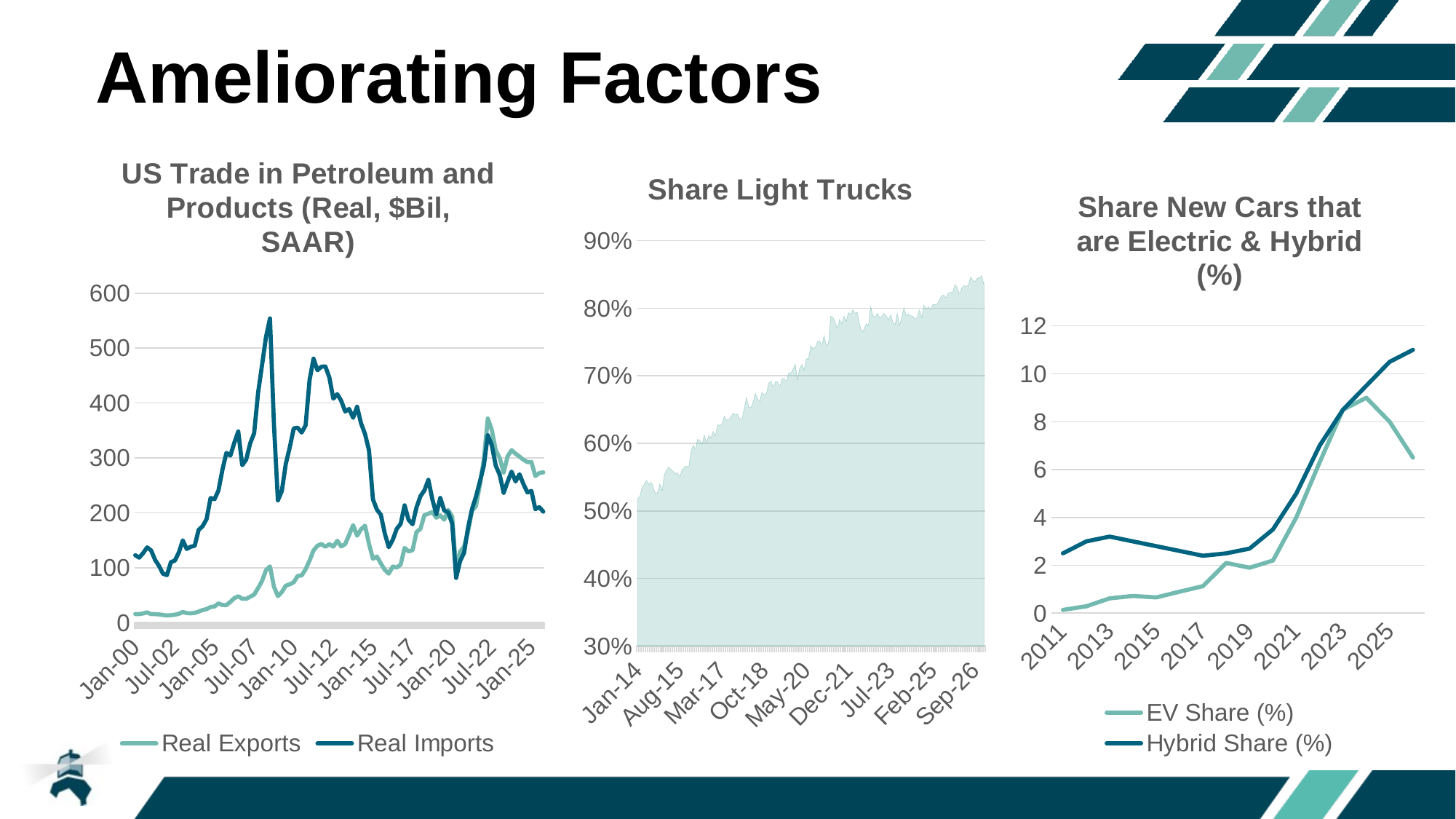
On the 'Share Light Trucks' chart, is the value at Sep-26 greater or less than 80%? greater On the 'US Trade in Petroleum and Products' chart, at Jan-00 which series is larger, Real Exports or Real Imports? Real Imports On the 'Share New Cars that are Electric & Hybrid (%)' chart, is the Hybrid Share (%) value in 2025 greater or less than 10? greater On the 'Share New Cars that are Electric & Hybrid (%)' chart, how many series does the legend list? 2 On the 'Share New Cars that are Electric & Hybrid (%)' chart, in 2025 which series is larger, EV Share (%) or Hybrid Share (%)? Hybrid Share (%) On the 'US Trade in Petroleum and Products' chart, what are the two series named in the legend? Real Exports and Real Imports On the 'US Trade in Petroleum and Products' chart, how many series does the legend list? 2 On the 'Share Light Trucks' chart, is the value at Jan-14 greater or less than 60%? less On the 'US Trade in Petroleum and Products' chart, what kind of chart is it? Line chart On the 'Share Light Trucks' chart, do the values generally rise or fall from Jan-14 to Sep-26? rise On the 'Share New Cars that are Electric & Hybrid (%)' chart, does the EV Share (%) rise or fall between 2023 and 2025? fall